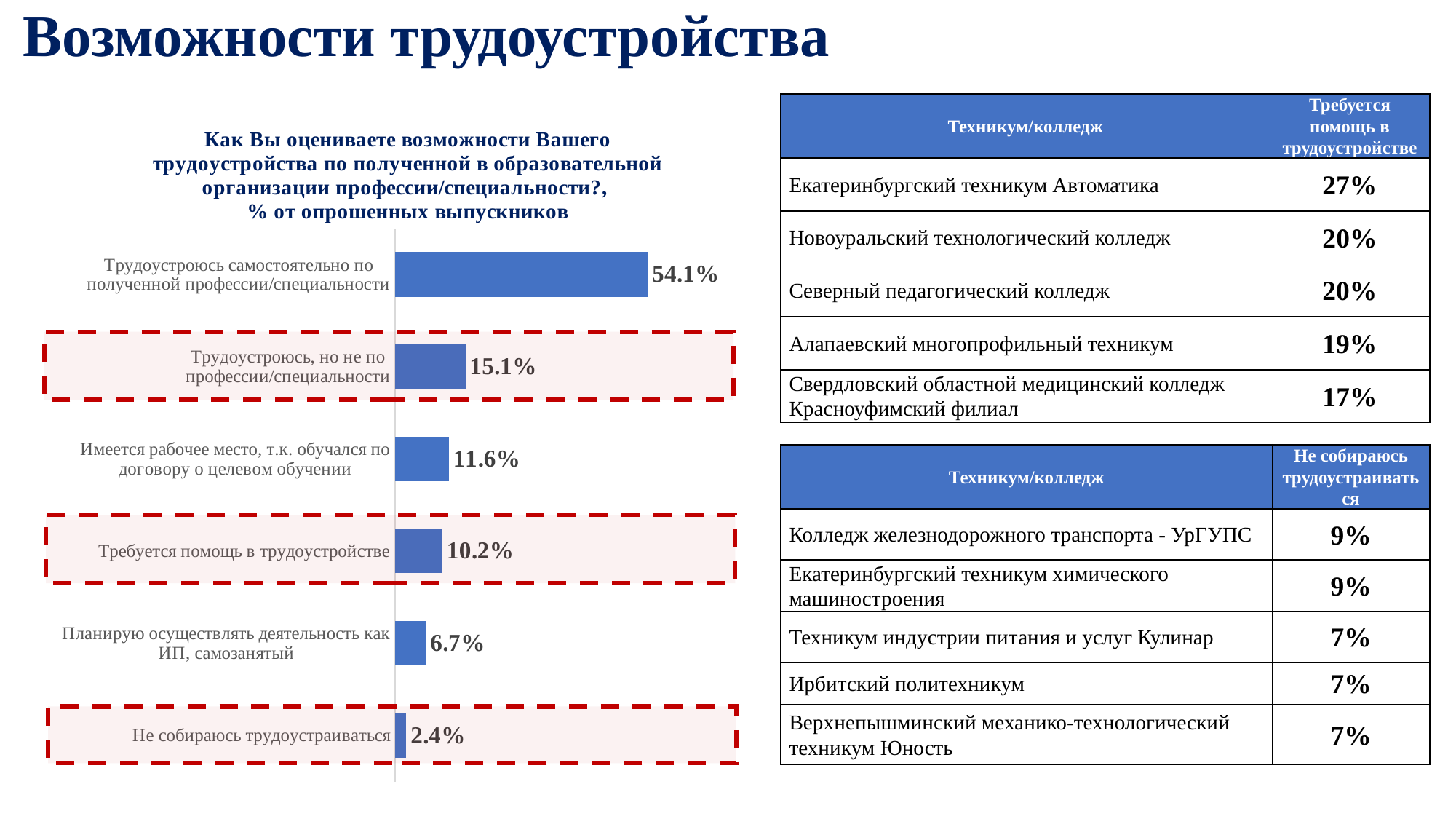
What is the value for "Требуется помощь в трудоустройстве"? 10.2% Which category has the lowest value? Не собираюсь трудоустраиваться What is the value for "Не собираюсь трудоустраиваться"? 2.4% What is the difference between the highest and lowest values in the chart? 51.7% How many categories in the chart are highlighted with a red dashed border? 3 What is the value for "Планирую осуществлять деятельность как ИП, самозанятый"? 6.7% What is the value for "Трудоустроюсь самостоятельно по полученной профессии/специальности"? 54.1% What kind of chart is shown on the slide? Bar chart What is the difference between "Трудоустроюсь, но не по профессии/специальности" and "Имеется рабочее место, т.к. обучался по договору о целевом обучении"? 3.5% Which category has the highest value? Трудоустроюсь самостоятельно по полученной профессии/специальности Which is larger: "Требуется помощь в трудоустройстве" or "Планирую осуществлять деятельность как ИП, самозанятый"? Требуется помощь в трудоустройстве How many categories does the chart show? 6